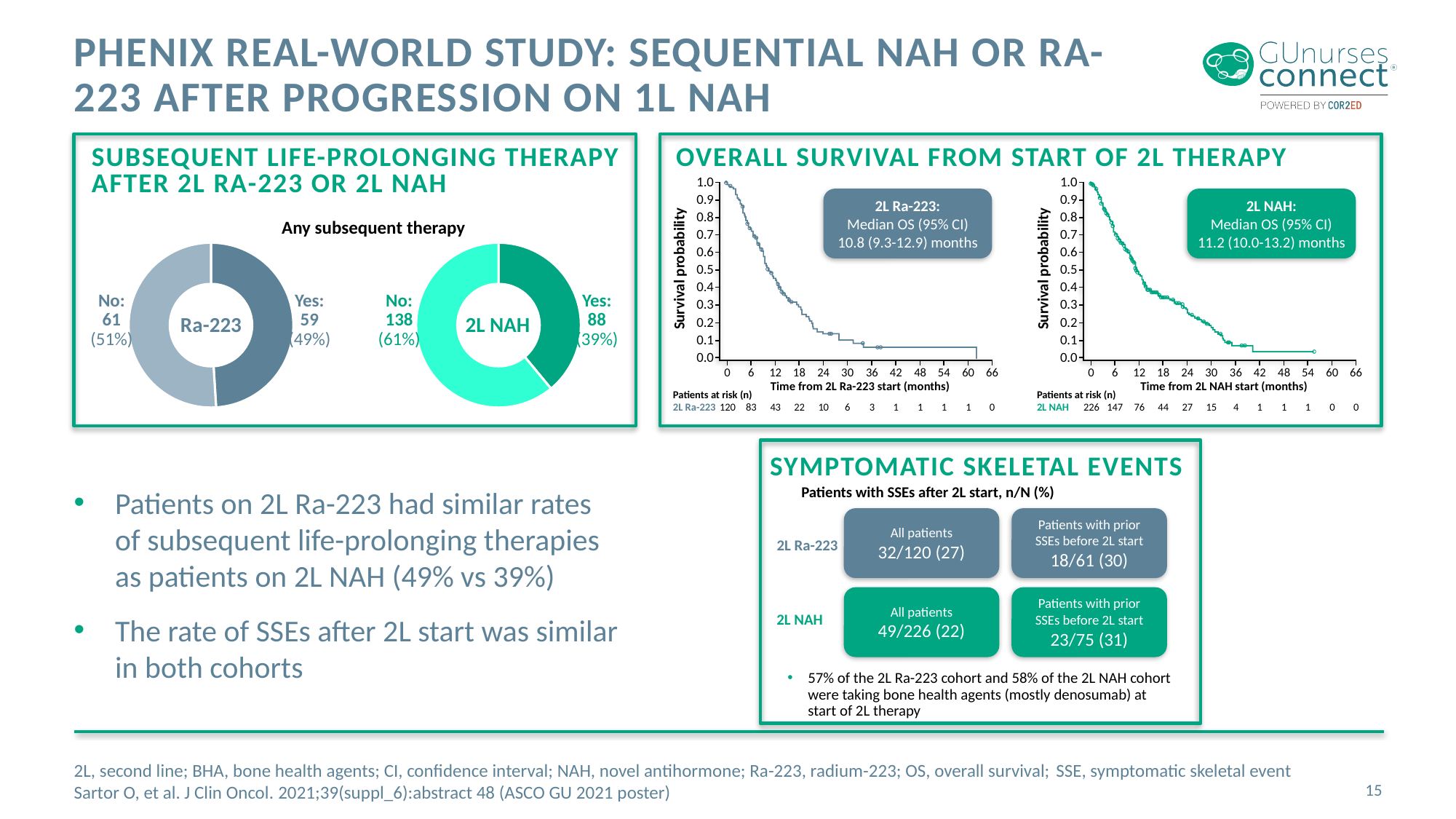
In the 'Overall survival from start of 2L therapy' panel, what is the median OS for 2L NAH? 11.2 months Comparing the two donut charts, which cohort has the larger 'Yes' share for any subsequent therapy, Ra-223 or 2L NAH? Ra-223 In the 2L NAH donut chart, what share of patients did not receive any subsequent therapy (No)? 61% In the 2L Ra-223 survival curve, how many patients are at risk at 0 months? 120 In the Ra-223 donut chart, what is the difference between the number of 'No' patients and the number of 'Yes' patients? 2 In the 2L NAH donut chart, how many patients are in the 'No' segment? 138 In the Ra-223 donut chart under 'Any subsequent therapy', how many patients are in the 'Yes' segment? 59 In the Ra-223 donut chart, what share of patients received any subsequent therapy (Yes)? 49% In the 2L NAH survival curve, how many patients are at risk at 12 months? 76 In the survival curves, does survival probability rise or fall as time from 2L start increases? Fall In the 'Overall survival from start of 2L therapy' panel, what is the median OS for 2L Ra-223? 10.8 months What kind of chart is used in the 'Subsequent life-prolonging therapy' panel? Pie chart (donut)